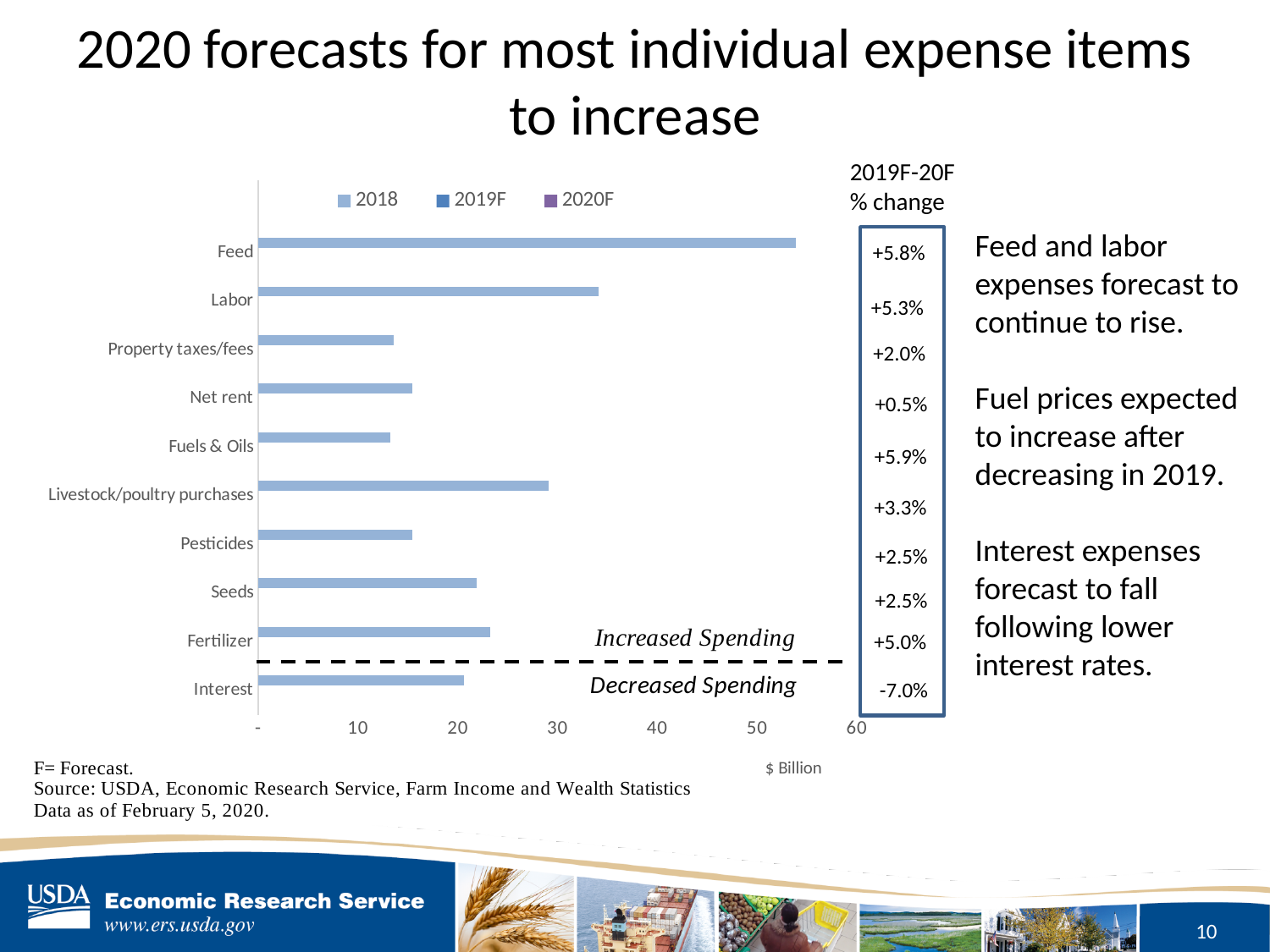
Is the value for Fuels & Oils greater or less than 10? greater How many series does the chart legend list? 3 Is the value for Fertilizer greater or less than 20? greater Which expense category has the longest bar on the chart? Feed Is the value for Net rent greater or less than 20? less How many expense categories are listed on the chart's vertical axis? 10 What kind of chart is shown on the slide? bar chart Which has the larger bar, Labor or Livestock/poultry purchases? Labor What unit is shown for the horizontal axis of the chart? $ Billion What are the three series names listed in the chart legend? 2018, 2019F, 2020F